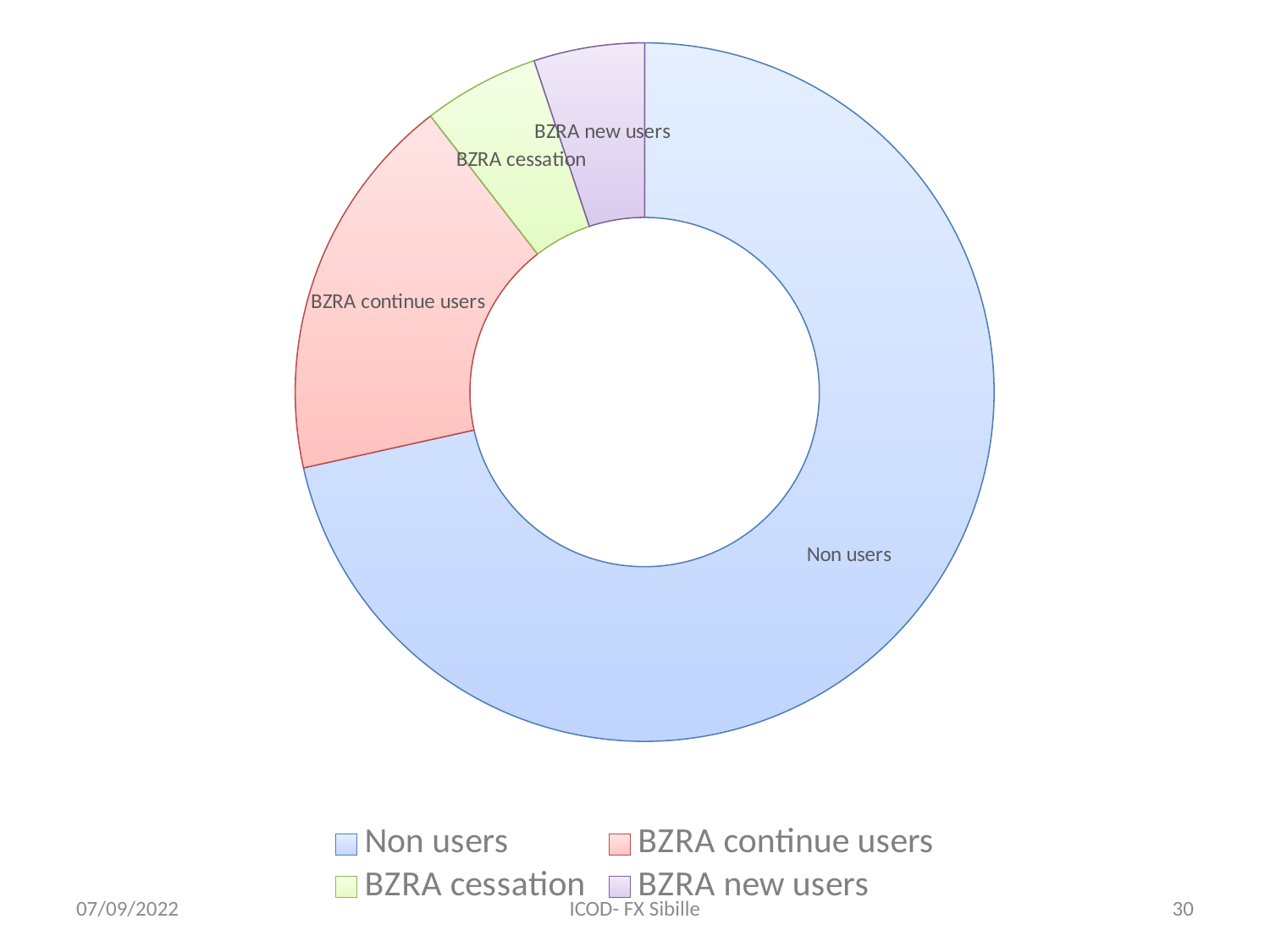
Which category is shown in red in the legend? BZRA continue users Which is larger, the share for BZRA continue users or the share for BZRA cessation? BZRA continue users Which is larger, the share for BZRA continue users or the share for BZRA new users? BZRA continue users Which category is the second largest in the chart? BZRA continue users What colour is the Non users slice? blue What kind of chart is shown on the slide? doughnut chart How many categories does the chart show? 4 Which is larger, the share for Non users or the share for BZRA continue users? Non users Which category has the largest share of the chart? Non users